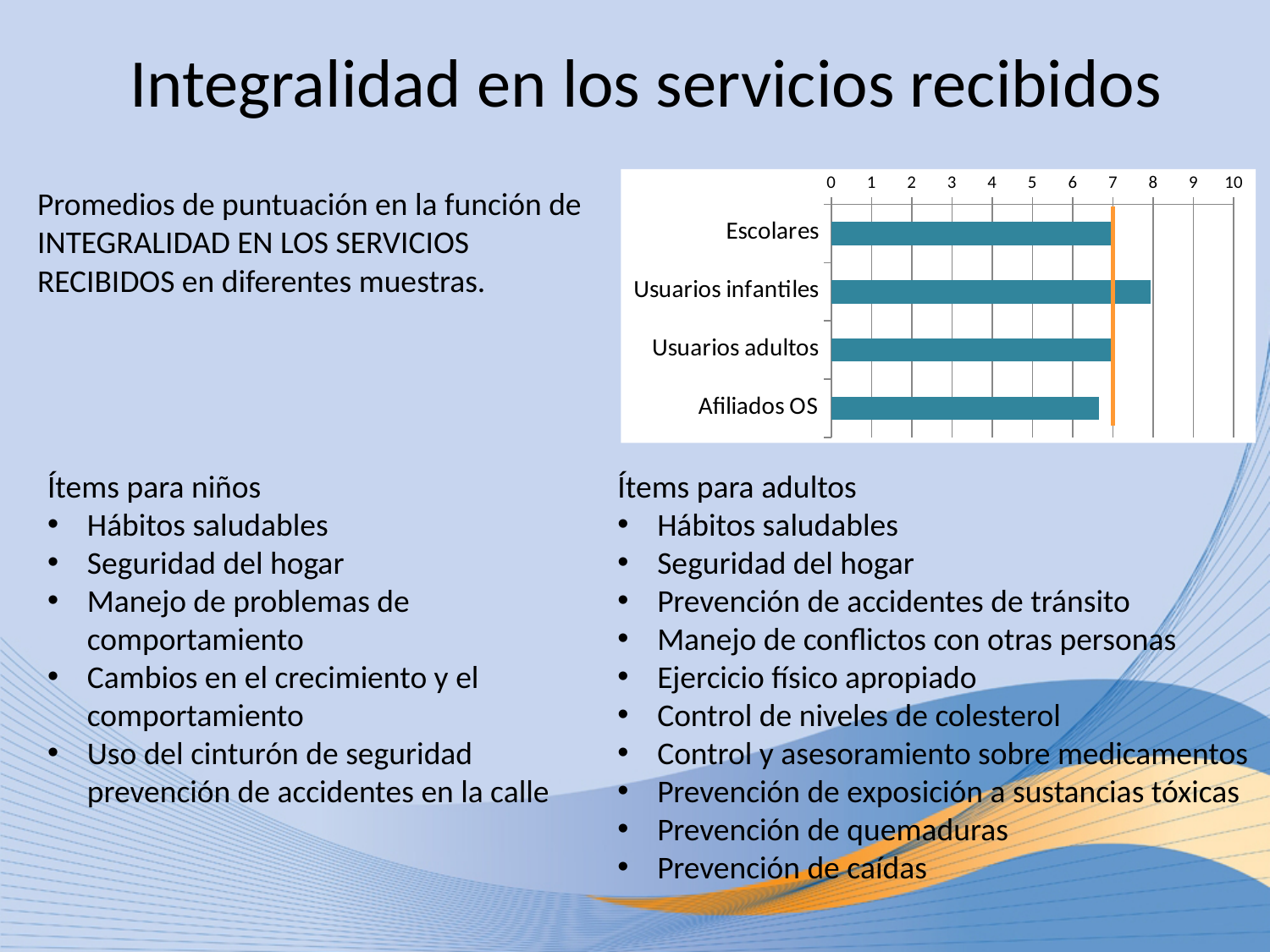
Is the value for Usuarios infantiles greater or less than 7? greater Is the value for Usuarios adultos greater or less than 5? greater Is the value for Afiliados OS greater or less than 7? less Which is larger, the value for Usuarios infantiles or the value for Escolares? Usuarios infantiles Which is larger, the value for Usuarios infantiles or the value for Afiliados OS? Usuarios infantiles At what axis value is the orange vertical reference line drawn on the chart? 7 What kind of chart is shown on the slide? bar chart How many categories are plotted in the bar chart? 4 What is the maximum value shown on the chart's horizontal axis? 10 Which category has the highest value in the bar chart? Usuarios infantiles